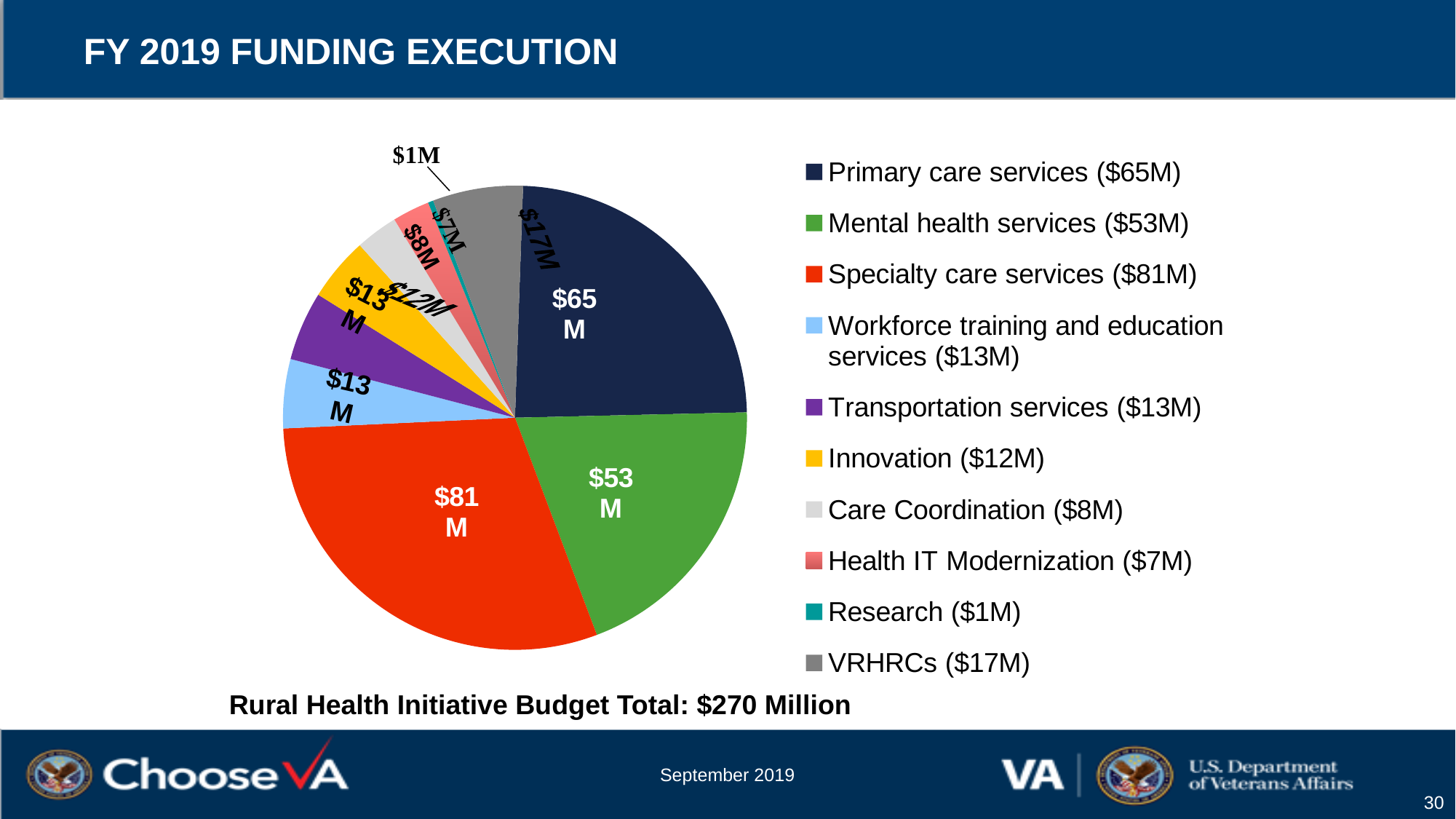
Which category has the largest slice of the pie? Specialty care services What is the value for Mental health services? $53M How many categories does the pie chart have? 10 What share of the $270 Million total does Specialty care services ($81M) represent? 30% What is the value for Research? $1M What is the difference between Specialty care services and Primary care services? $16M What is the value for VRHRCs? $17M What is the value for Specialty care services? $81M Which is larger, Primary care services or Mental health services? Primary care services Which category has the smallest slice of the pie? Research What is the Rural Health Initiative Budget Total stated below the chart? $270 Million What type of chart is shown on the slide? Pie chart